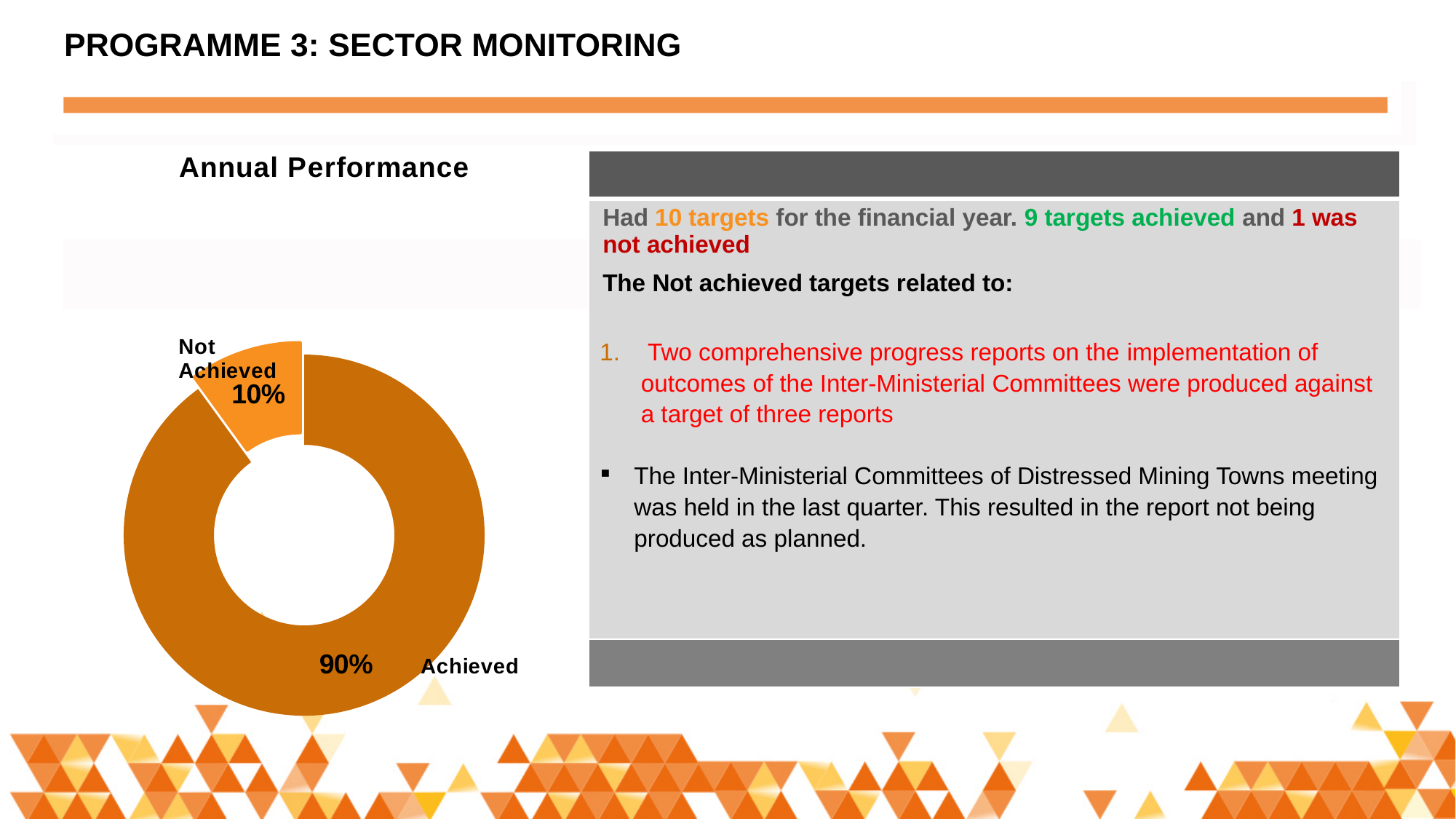
What is the total of the two shares shown in the chart? 100% What kind of chart is shown on the slide? Doughnut (pie) chart Which category has the smallest share in the chart? Not Achieved Which category has the largest share in the chart? Achieved Which is larger, the Achieved share or the Not Achieved share? Achieved What is the title shown above the chart? Annual Performance How many categories are shown in the chart? 2 What percentage of targets were Not Achieved according to the chart? 10% What percentage of targets were Achieved according to the chart? 90% What is the difference in percentage points between the Achieved and Not Achieved shares? 80 What colour is the Not Achieved slice in the chart? Light orange